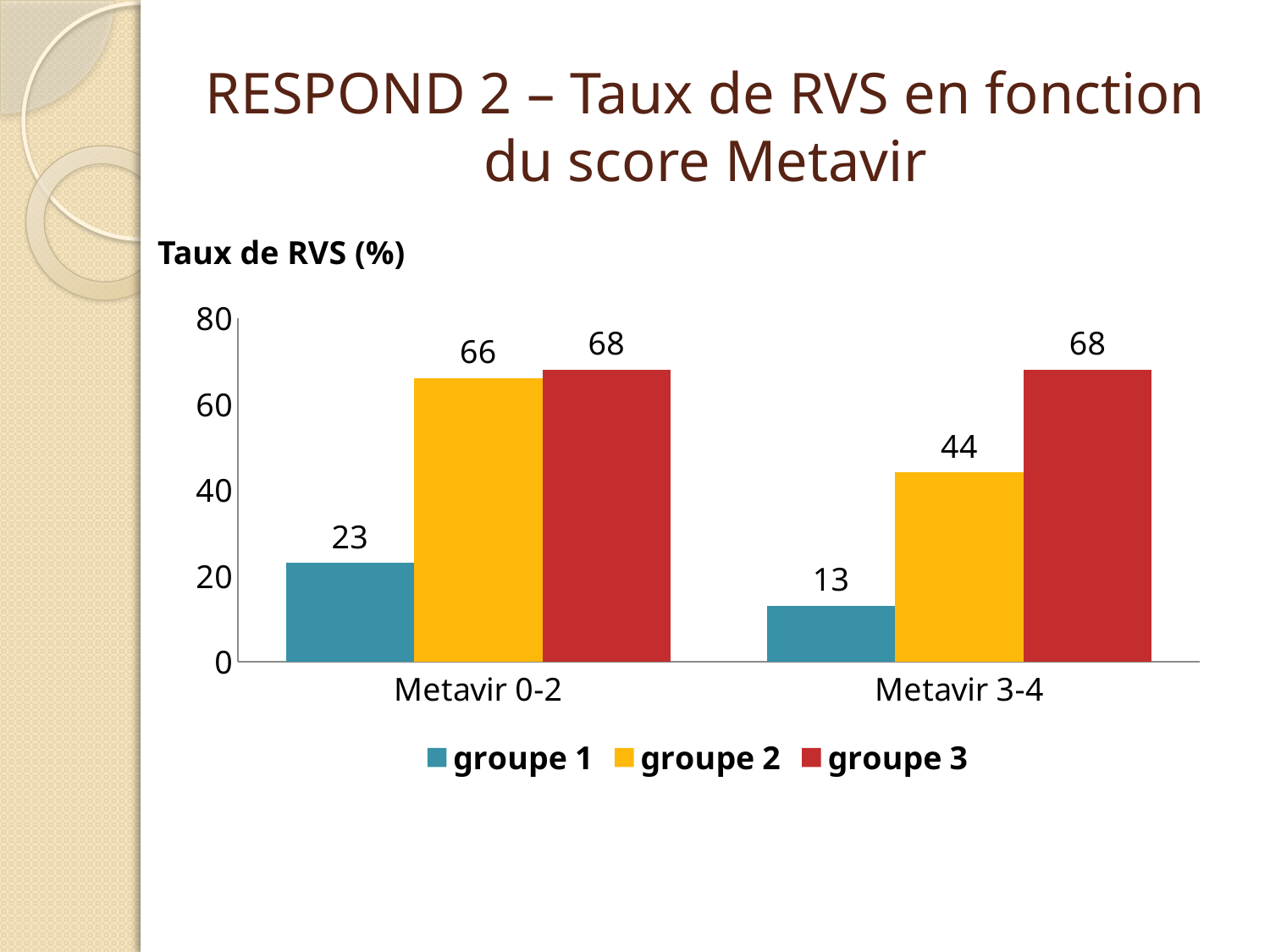
What is the difference between groupe 2 in Metavir 0-2 and groupe 2 in Metavir 3-4? 22 Which series has the highest value in the Metavir 0-2 category? groupe 3 What is the value for groupe 2 in the Metavir 3-4 category? 44 Is the value for groupe 2 in Metavir 3-4 greater or less than 40? greater What is the value for groupe 3 in the Metavir 0-2 category? 68 How many categories are shown on the x axis? 2 What kind of chart is shown on the slide? bar chart What is the value for groupe 1 in the Metavir 0-2 category? 23 Which series has the lowest value in the Metavir 3-4 category? groupe 1 How many series does the legend list? 3 Which is larger: groupe 1 in Metavir 0-2 or groupe 1 in Metavir 3-4? groupe 1 in Metavir 0-2 What is the label of the y axis? Taux de RVS (%)